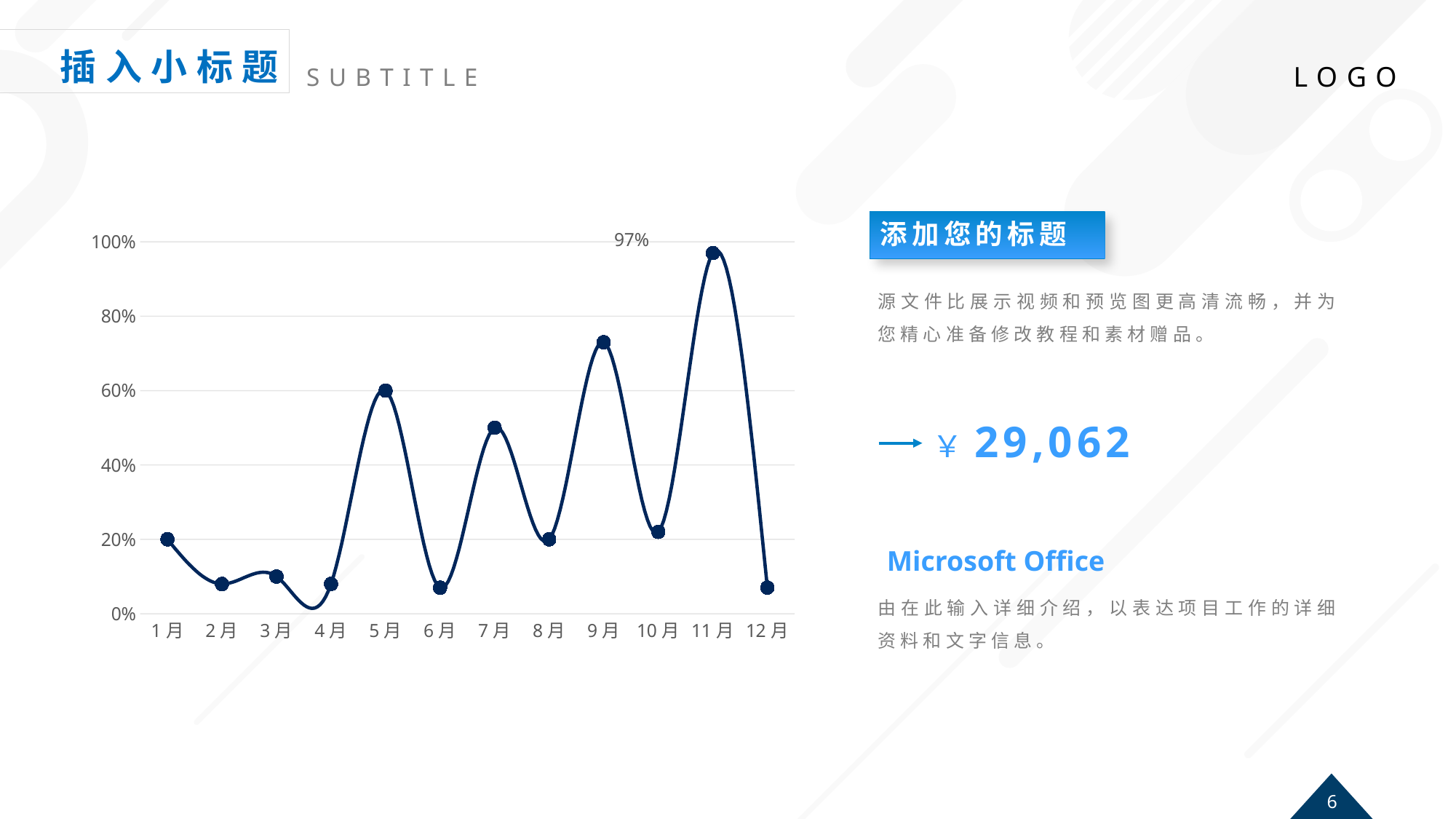
Is the value for 7月 greater or less than 40%? greater What is the value for 5月 in the line chart? 60% From 11月 to 12月, does the value rise or fall? fall Which is larger, the value for 5月 or the value for 7月? 5月 Which month has the highest value in the line chart? 11月 Which is larger, the value for 9月 or the value for 11月? 11月 What is the value for 11月 in the line chart? 97% How many months are plotted on the x axis of the line chart? 12 Is the value for 3月 greater or less than 20%? less Is the value for 9月 greater or less than 60%? greater What kind of chart is shown on the slide? line chart